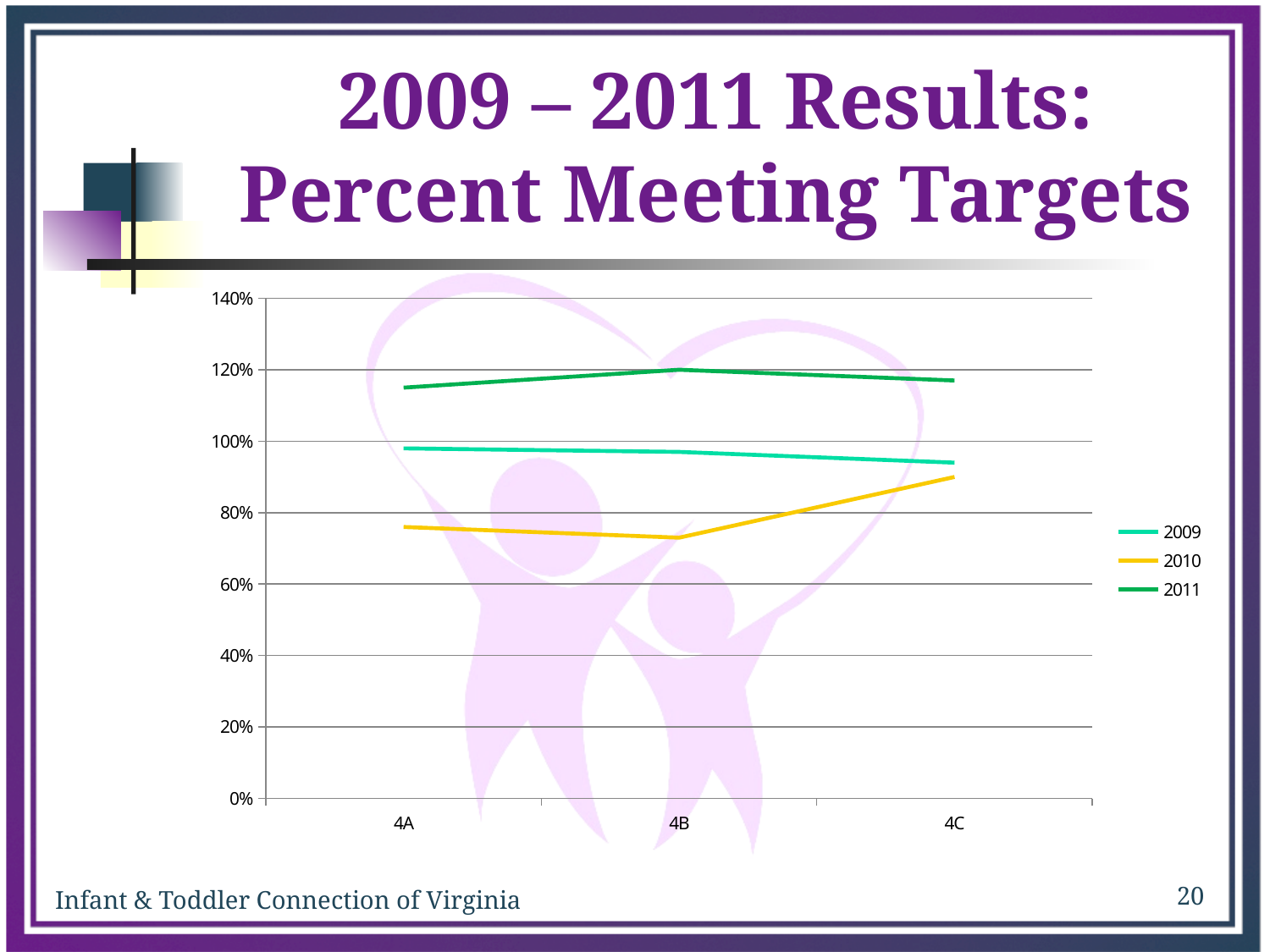
Which series has the lowest value at 4C? 2010 How many categories are shown on the x axis? 3 Is the value for 2010 at 4A greater or less than 80%? less At 4B, which is larger: the value for 2011 or the value for 2010? 2011 What kind of chart is shown on the slide? line chart Which series has the highest value at 4A? 2011 Is the value for 2009 at 4C greater or less than 80%? greater Is the value for 2010 at 4C greater or less than 80%? greater Do the values for the 2009 series rise or fall from 4A to 4C? fall For the 2010 series, which category has the highest value? 4C How many series does the legend list? 3